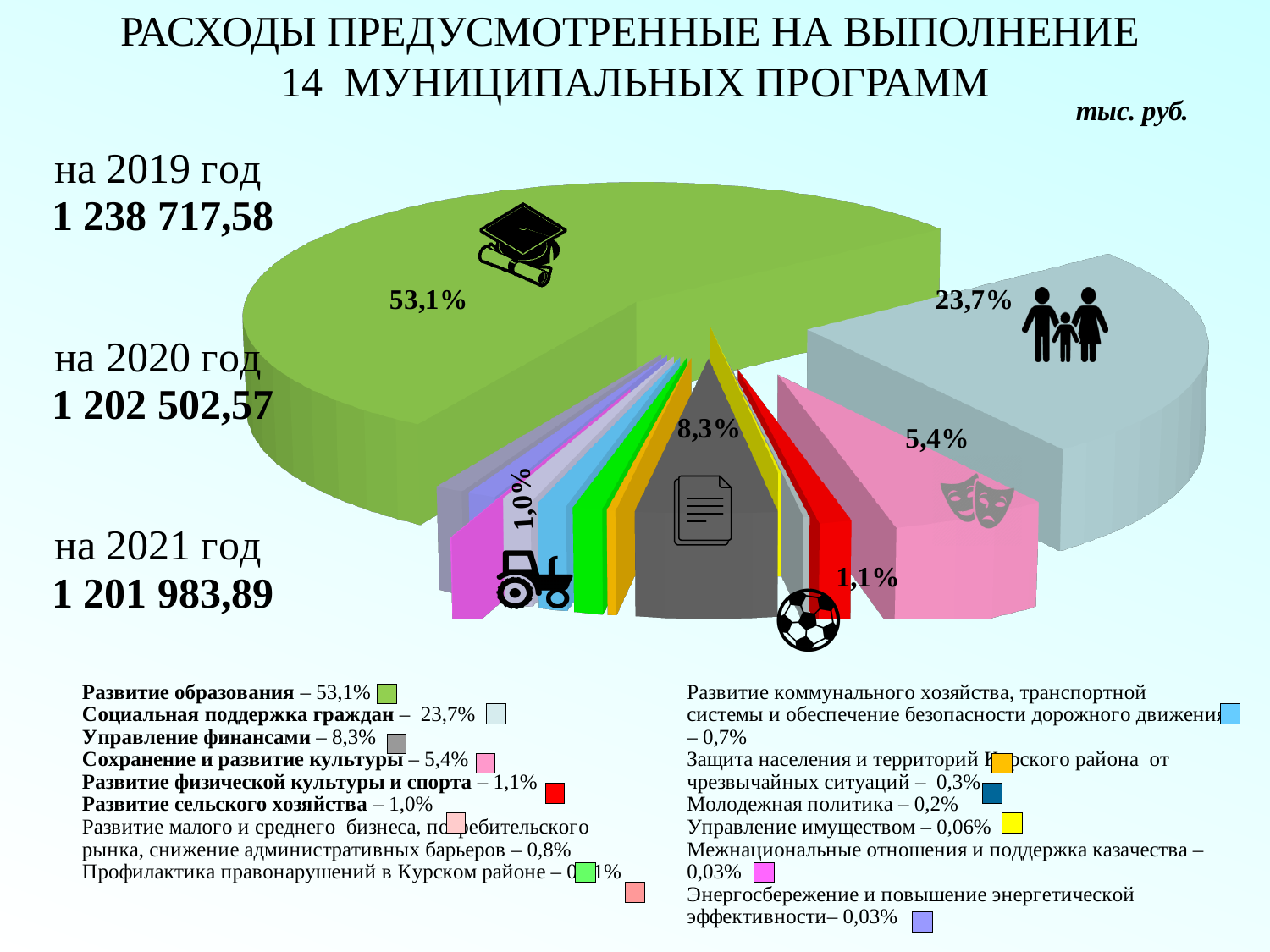
What percentage is shown for Социальная поддержка граждан? 23,7% Which is larger: the share for Управление финансами or for Сохранение и развитие культуры? Управление финансами What percentage is shown for Сохранение и развитие культуры? 5,4% Which program has the largest share of the pie? Развитие образования What kind of chart is shown on the slide? Pie chart What is the difference in percentage points between Развитие образования and Социальная поддержка граждан? 29,4 What unit is indicated for the expenditure figures on the slide? тыс. руб. What percentage is shown for Управление финансами? 8,3% What percentage is shown for Развитие физической культуры и спорта? 1,1% What share of the pie does Развитие сельского хозяйства take? 1,0% What percentage is shown for Развитие образования? 53,1% What is the difference in percentage points between Социальная поддержка граждан and Управление финансами? 15,4